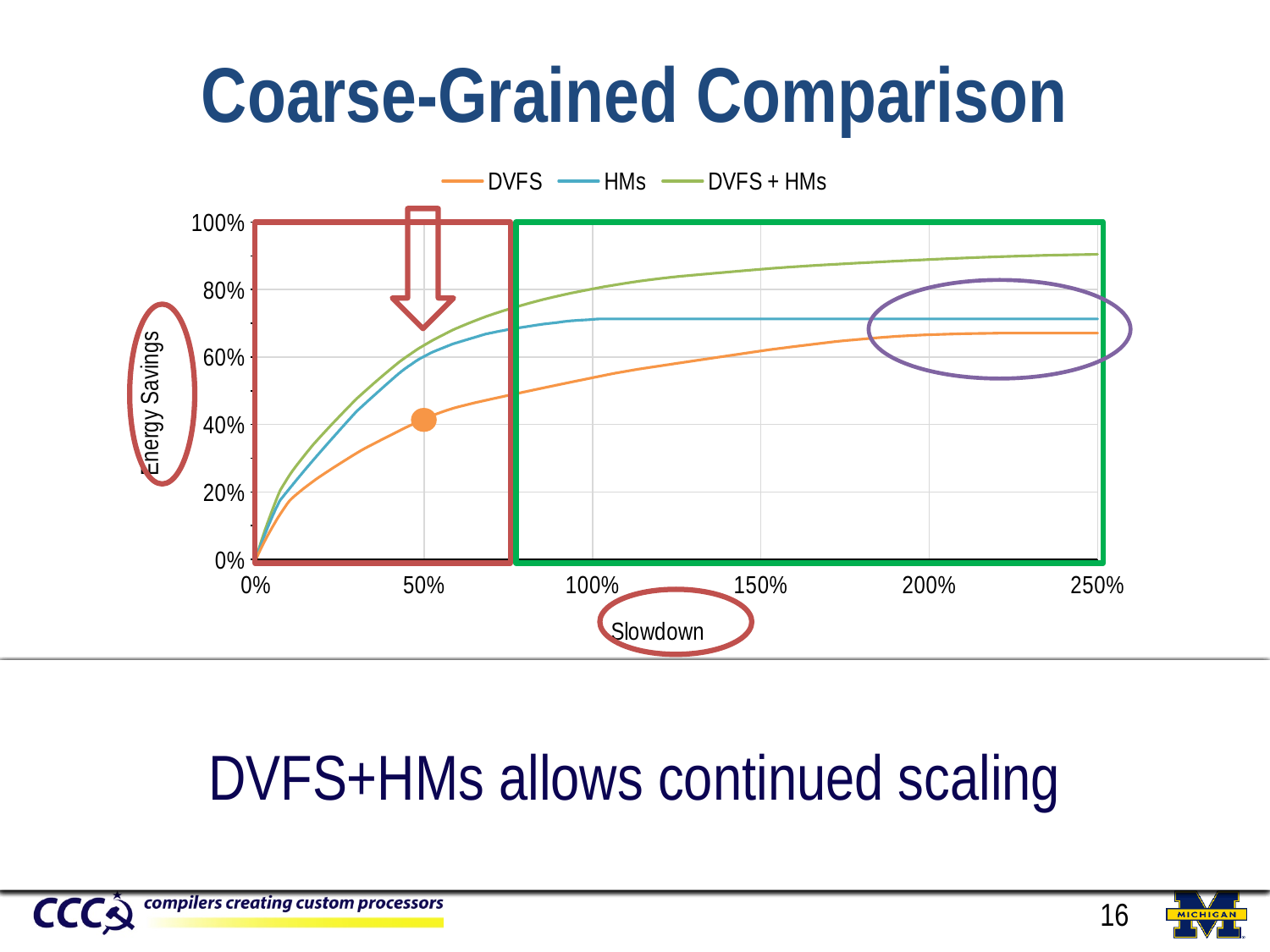
Is the energy savings value for DVFS at 50% slowdown greater or less than 60%? less What kind of chart is shown on the slide? line chart Is the energy savings value for DVFS + HMs at 250% slowdown greater or less than 80%? greater Is the energy savings value for HMs at 250% slowdown greater or less than 80%? less At 250% slowdown, which series has higher energy savings, DVFS or HMs? HMs Does the DVFS + HMs line rise or fall as slowdown increases? rise How many series does the legend list? 3 What are the three series named in the legend? DVFS, HMs, DVFS + HMs Which series has the highest energy savings at 250% slowdown? DVFS + HMs Which series has the lowest energy savings at 100% slowdown? DVFS What is the title of the x axis? Slowdown